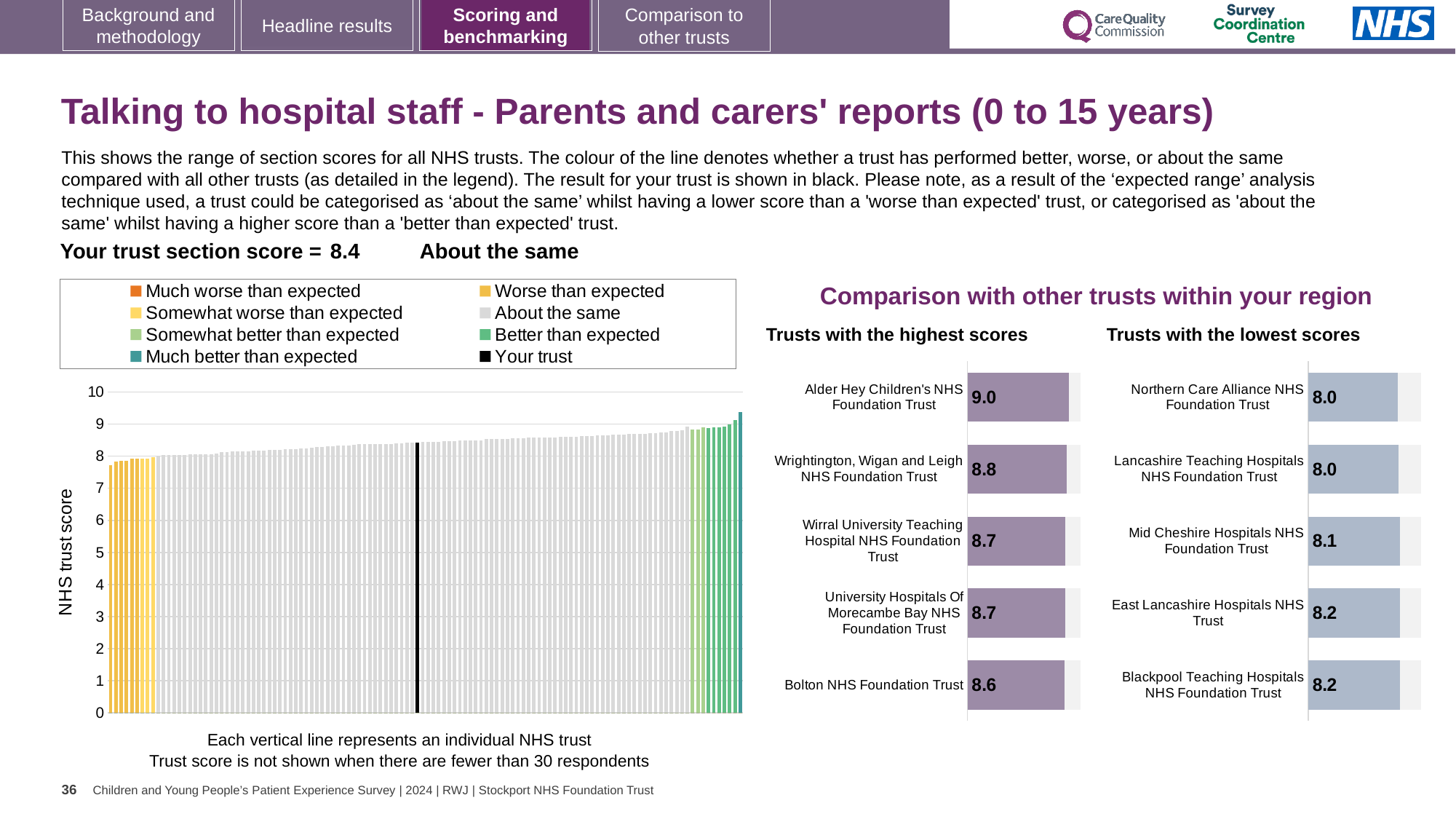
In the 'Trusts with the highest scores' chart, what is the score for Alder Hey Children's NHS Foundation Trust? 9.0 In the 'Trusts with the highest scores' chart, what is the score for Bolton NHS Foundation Trust? 8.6 In the 'Trusts with the highest scores' chart, which trust has the highest score? Alder Hey Children's NHS Foundation Trust In the 'Trusts with the lowest scores' chart, which has the higher score: Northern Care Alliance NHS Foundation Trust or East Lancashire Hospitals NHS Trust? East Lancashire Hospitals NHS Trust In the 'Trusts with the highest scores' chart, what is the difference between the scores of Alder Hey Children's NHS Foundation Trust and Bolton NHS Foundation Trust? 0.4 In the main chart on the left showing all NHS trusts, do the bar values rise or fall from left to right? rise In the main chart on the left showing all NHS trusts, is the value for the black bar (your trust) greater or less than 8? greater In the 'Trusts with the lowest scores' chart, what is the score for Mid Cheshire Hospitals NHS Foundation Trust? 8.1 How many entries does the legend of the main chart on the left list? 8 In the 'Trusts with the highest scores' chart, which trust has the lowest score? Bolton NHS Foundation Trust In the 'Trusts with the highest scores' chart, how many trusts are listed? 5 In the 'Trusts with the lowest scores' chart, what is the score for Blackpool Teaching Hospitals NHS Foundation Trust? 8.2